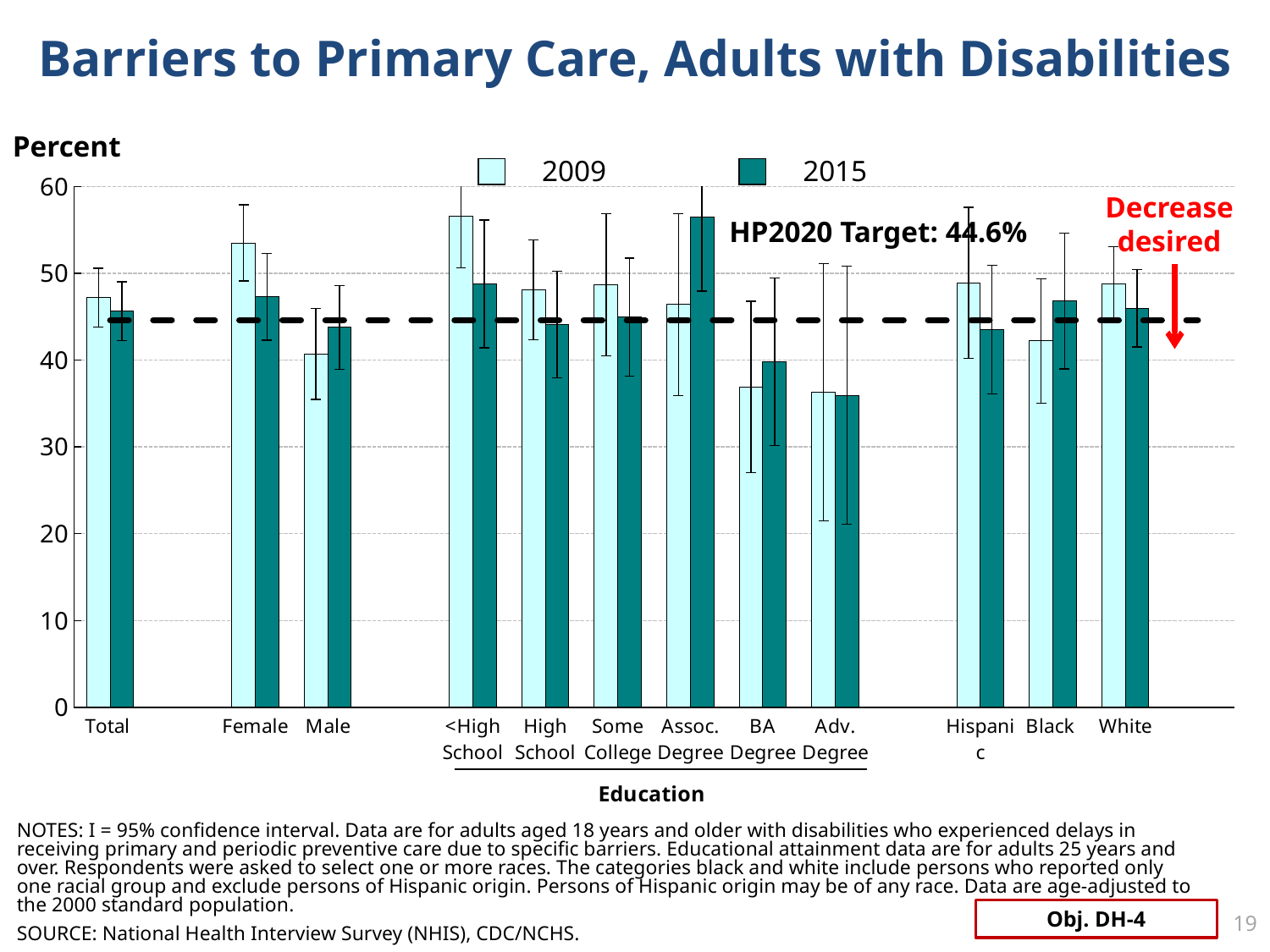
Which category has the highest 2009 value? <High School Is the 2015 value for Adv. Degree greater or less than 40? less How many categories are shown along the x axis? 12 Which is larger, the 2015 value for Assoc. Degree or the 2015 value for BA Degree? Assoc. Degree Which two years are shown in the legend? 2009 and 2015 How many series does the legend list? 2 Which category has the highest 2015 value? Assoc. Degree What is the HP2020 Target value shown on the chart? 44.6% Which is larger, the 2009 value for Female or the 2009 value for Male? Female What kind of chart is shown on the slide? bar chart Is the 2009 value for Female greater or less than 50? greater Which category has the lowest 2015 value? Adv. Degree